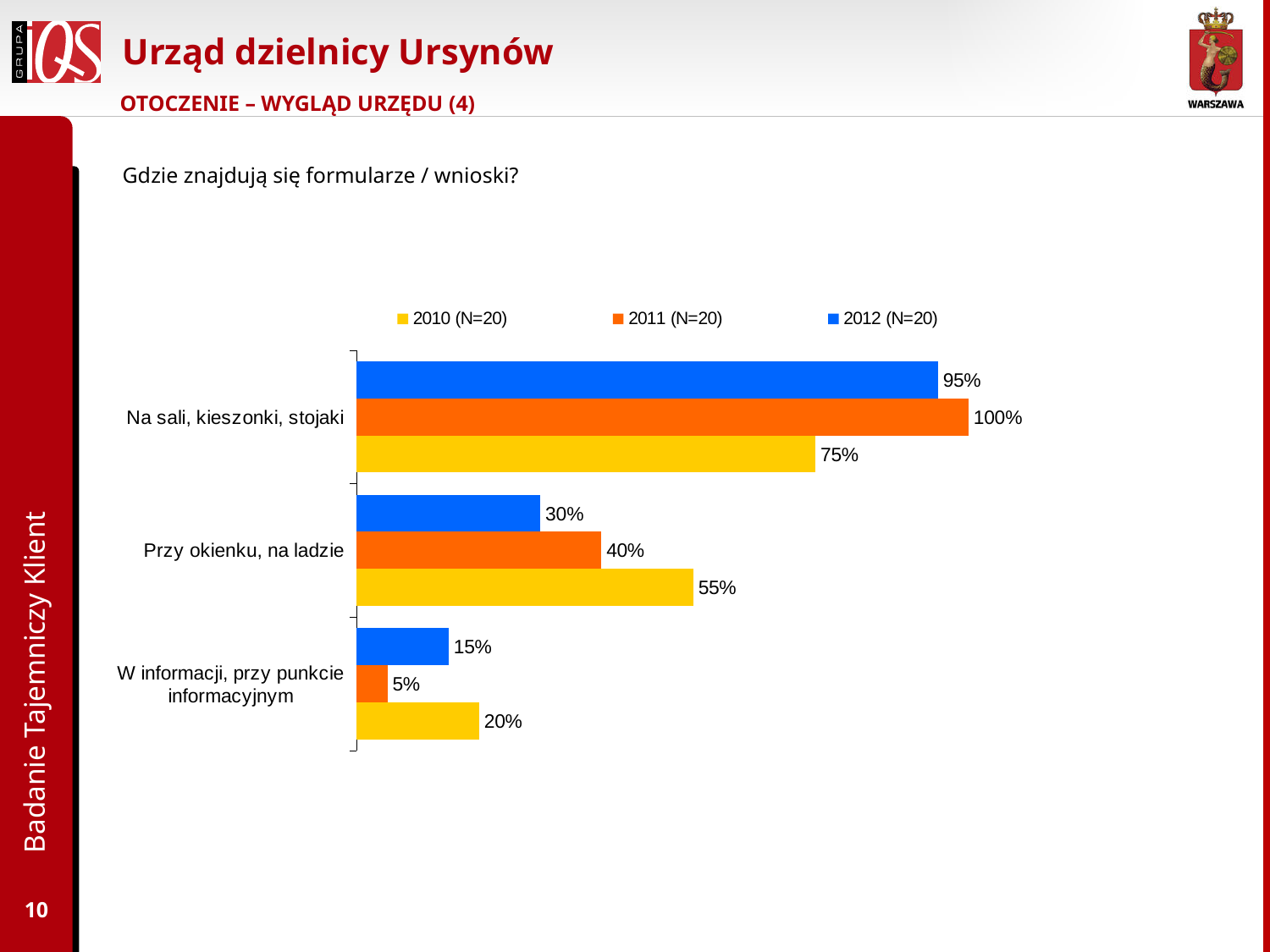
Which category has the highest value in the 2012 (N=20) series? Na sali, kieszonki, stojaki What is the value for 'W informacji, przy punkcie informacyjnym' in the 2011 (N=20) series? 5% What is the value for 'W informacji, przy punkcie informacyjnym' in the 2012 (N=20) series? 15% For 'Przy okienku, na ladzie', which series has the larger value: 2010 (N=20) or 2012 (N=20)? 2010 (N=20) What is the value for 'Przy okienku, na ladzie' in the 2010 (N=20) series? 55% What is the value for 'Na sali, kieszonki, stojaki' in the 2011 (N=20) series? 100% Which colour represents the 2012 (N=20) series in the legend? Blue How many categories are shown on the chart? 3 What is the difference between the 2011 (N=20) and 2010 (N=20) values for 'Na sali, kieszonki, stojaki'? 25% How many series does the legend list? 3 What kind of chart is shown on the slide? Bar chart Which category has the lowest value in the 2011 (N=20) series? W informacji, przy punkcie informacyjnym